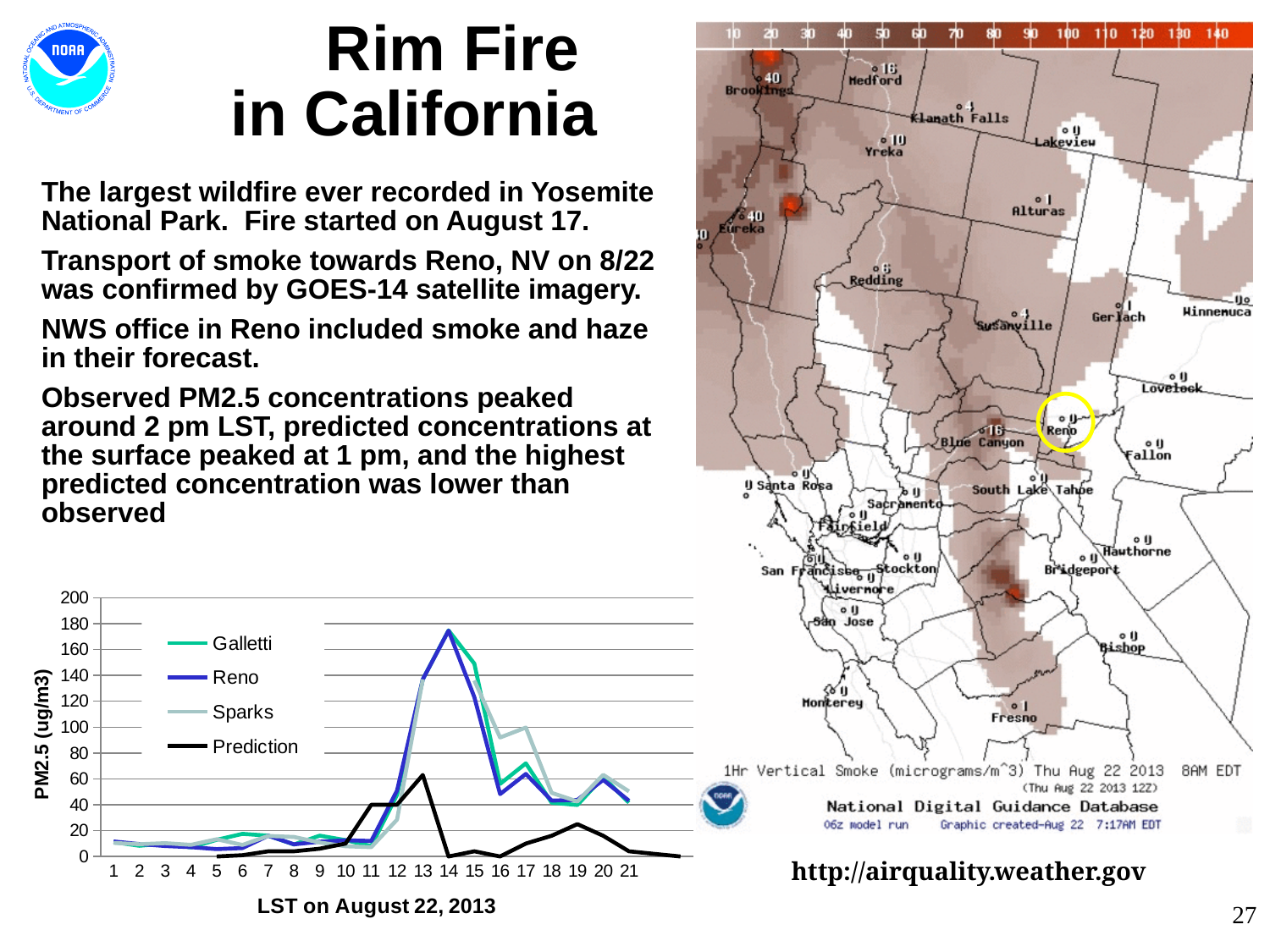
What kind of chart is shown at the bottom left of the slide? line chart In the PM2.5 chart, which series has the lowest peak value? Prediction In the PM2.5 chart, at which hour does the Reno series reach its highest value? 14 In the PM2.5 chart, at hour 13, which is larger: the Reno value or the Prediction value? Reno In the PM2.5 chart, is the Prediction value at hour 13 greater or less than 40? greater In the PM2.5 chart, is the Prediction value at hour 14 greater or less than 100? less How many series does the legend of the PM2.5 chart list? 4 In the PM2.5 chart, at which hour does the Prediction series reach its highest value? 13 What is the y-axis label of the PM2.5 chart? PM2.5 (ug/m3) In the PM2.5 chart, is the Reno value at hour 14 greater or less than 160? greater How many hourly points are shown along the x axis of the PM2.5 chart? 21